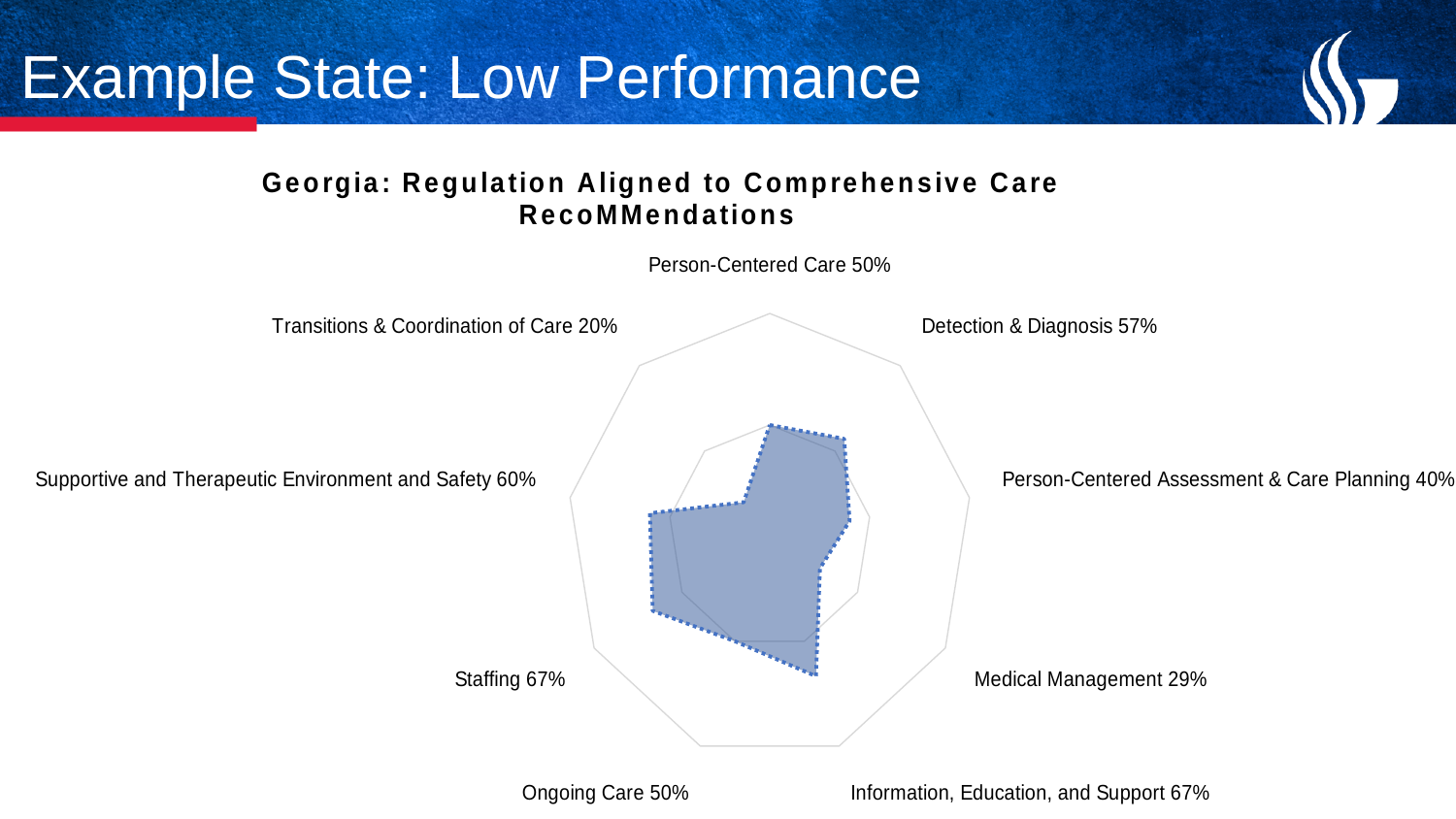
What kind of chart is shown on the slide? Radar chart What is the value for Transitions & Coordination of Care? 20% How many categories does the chart show? 9 What is the value for Detection & Diagnosis? 57% What is the title of the chart? Georgia: Regulation Aligned to Comprehensive Care RecoMMendations What is the value for Person-Centered Assessment & Care Planning? 40% Which category has the lowest value? Transitions & Coordination of Care What is the difference between the values for Detection & Diagnosis and Person-Centered Care? 7% What is the value for Supportive and Therapeutic Environment and Safety? 60% What is the difference between the values for Staffing and Medical Management? 38% Which is larger, the value for Ongoing Care or the value for Person-Centered Assessment & Care Planning? Ongoing Care What is the value for Medical Management? 29%